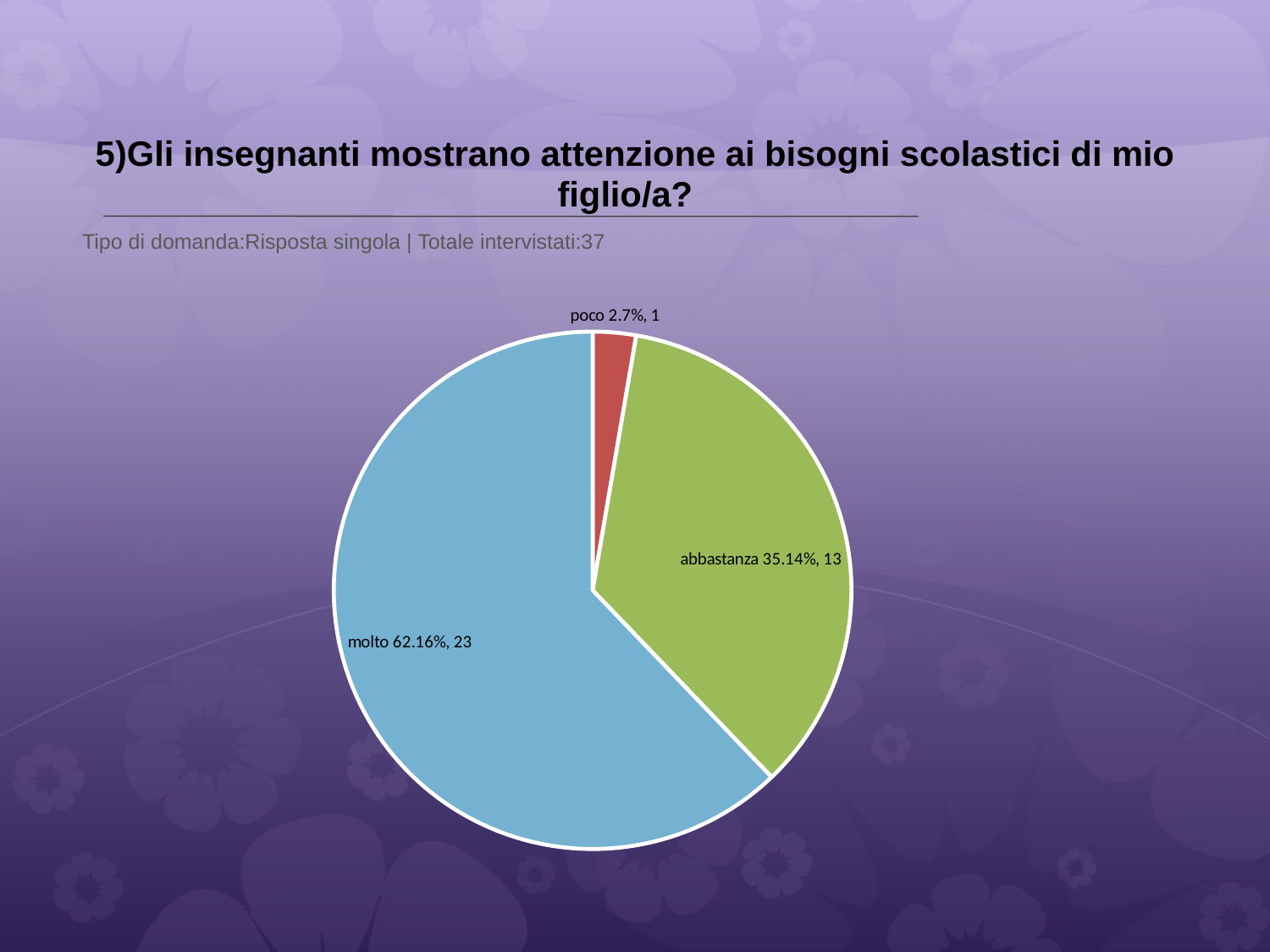
Which response category has the largest slice? molto What percentage share does the 'poco' slice have? 2.7% What is the difference in number of respondents between 'molto' and 'abbastanza'? 10 What percentage share does the 'abbastanza' slice have? 35.14% How many respondents answered 'abbastanza'? 13 What colour is the 'abbastanza' slice? green What kind of chart is shown on the slide? pie chart How many slices does the pie chart have? 3 Which response category has the smallest slice? poco How many respondents answered 'poco'? 1 What percentage share does the 'molto' slice have? 62.16% How many respondents answered 'molto'? 23